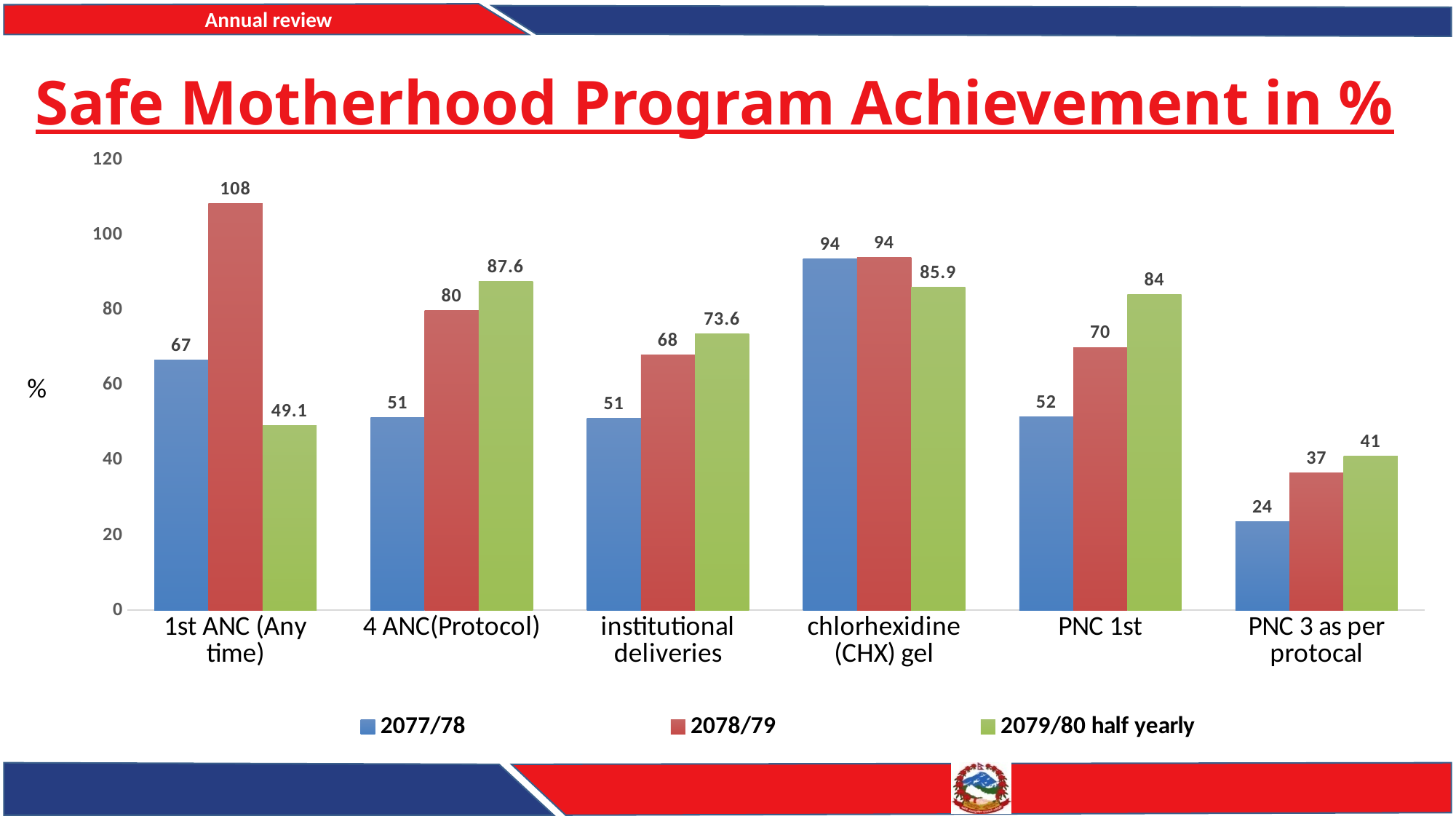
What is the difference between the 2079/80 half yearly and 2077/78 values for 4 ANC(Protocol)? 36.6 What is the value for PNC 3 as per protocal in the 2077/78 series? 24 What is the value for institutional deliveries in the 2079/80 half yearly series? 73.6 How many series does the legend list? 3 Which colour represents the 2078/79 series in the legend? red How many categories are shown on the x axis? 6 Which category has the lowest value in the 2079/80 half yearly series? PNC 3 as per protocal What is the title of the chart? Safe Motherhood Program Achievement in % What kind of chart is shown on the slide? bar chart Which category has the highest value in the 2077/78 series? chlorhexidine (CHX) gel Which is larger for PNC 1st: the 2078/79 value or the 2079/80 half yearly value? 2079/80 half yearly What is the value for 1st ANC (Any time) in the 2078/79 series? 108